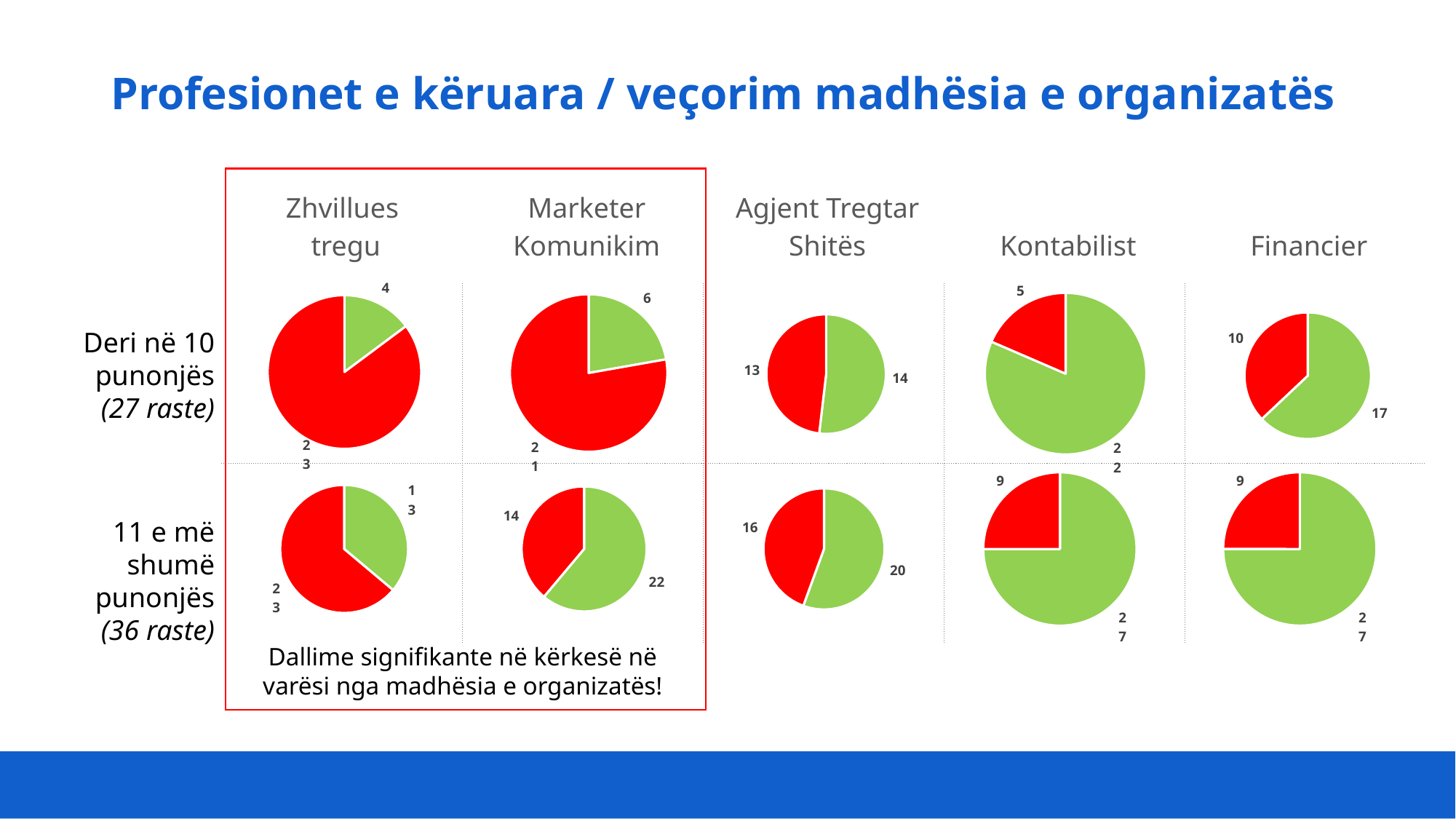
How many pie charts are shown on the slide? 10 In the pie chart for Marketer Komunikim in the 'Deri në 10 punonjës' row, what value is shown for the red slice? 21 In the pie chart for Financier in the '11 e më shumë punonjës' row, what value is shown for the red slice? 9 In the pie chart for Agjent Tregtar Shitës in the '11 e më shumë punonjës' row, what value is shown for the green slice? 20 What type of chart is used on this slide? pie chart In the pie chart for Zhvillues tregu in the 'Deri në 10 punonjës' row, what is the difference between the red slice value and the green slice value? 19 In the pie chart for Kontabilist in the '11 e më shumë punonjës' row, what share of the pie does the green slice represent? 75% In the pie chart for Zhvillues tregu in the 'Deri në 10 punonjës' row, what value is shown for the green slice? 4 In the pie chart for Kontabilist in the 'Deri në 10 punonjës' row, what value is shown for the red slice? 5 Which two professions are enclosed in the red box on the slide? Zhvillues tregu and Marketer Komunikim In the pie chart for Financier in the 'Deri në 10 punonjës' row, what is the total of the two slice values? 27 In the pie chart for Marketer Komunikim in the '11 e më shumë punonjës' row, which slice is larger, the green one or the red one? green